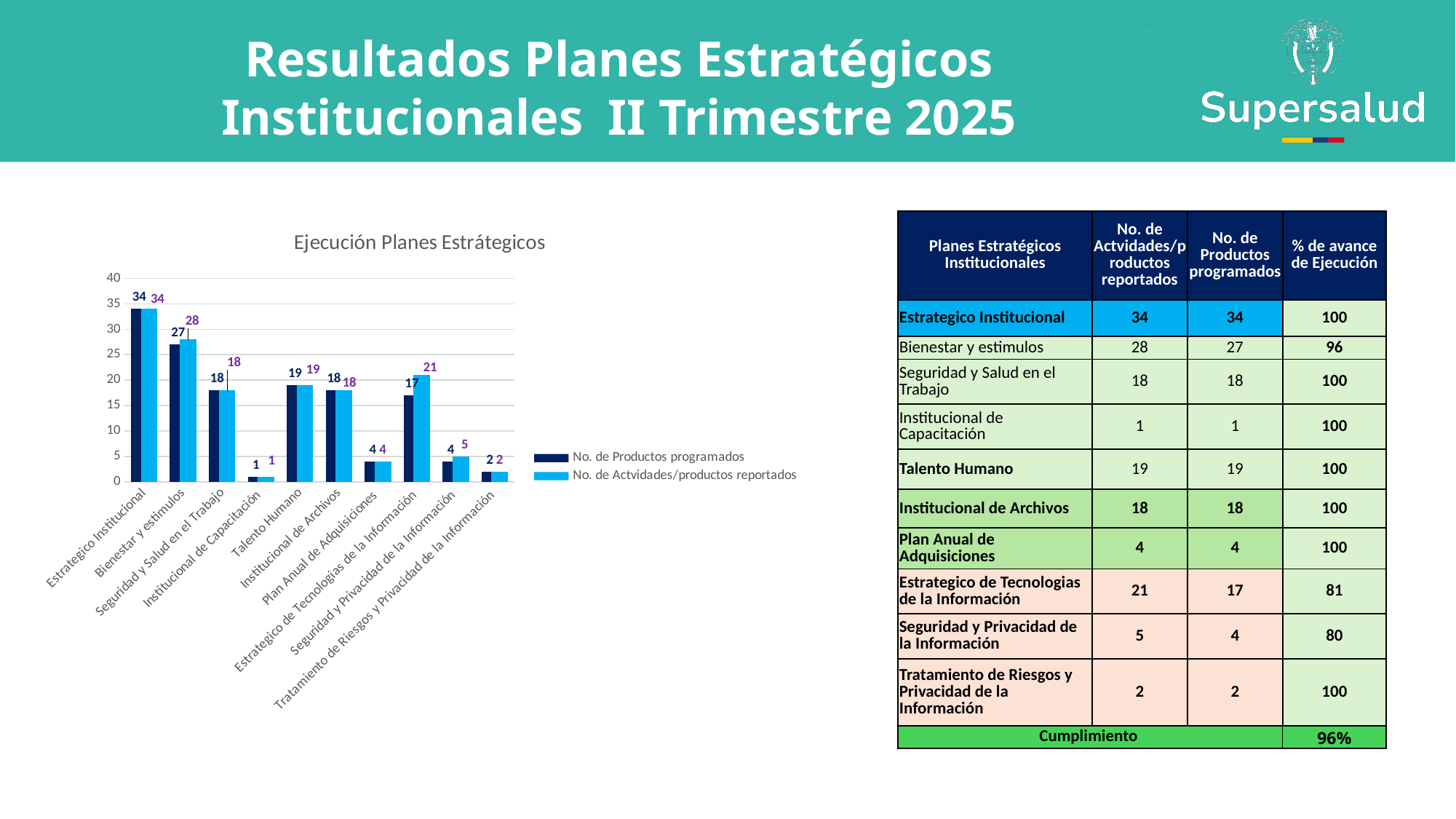
Which category has the lowest value for No. de Actvidades/productos reportados? Institucional de Capacitación What is the value of No. de Actvidades/productos reportados for Estrategico de Tecnologias de la Información? 21 What is the value of No. de Actvidades/productos reportados for Bienestar y estimulos? 28 What is the value of No. de Productos programados for Estrategico Institucional? 34 Which category has the highest value for No. de Productos programados? Estrategico Institucional Is the value of No. de Productos programados for Talento Humano greater or less than 15? greater Which is larger for Seguridad y Privacidad de la Información: No. de Productos programados or No. de Actvidades/productos reportados? No. de Actvidades/productos reportados What kind of chart is shown on the slide? Bar chart How many series does the chart legend list? 2 What is the title of the chart? Ejecución Planes Estrátegicos How many categories are shown on the x axis of the chart? 10 What is the difference between No. de Actvidades/productos reportados and No. de Productos programados for Estrategico de Tecnologias de la Información? 4